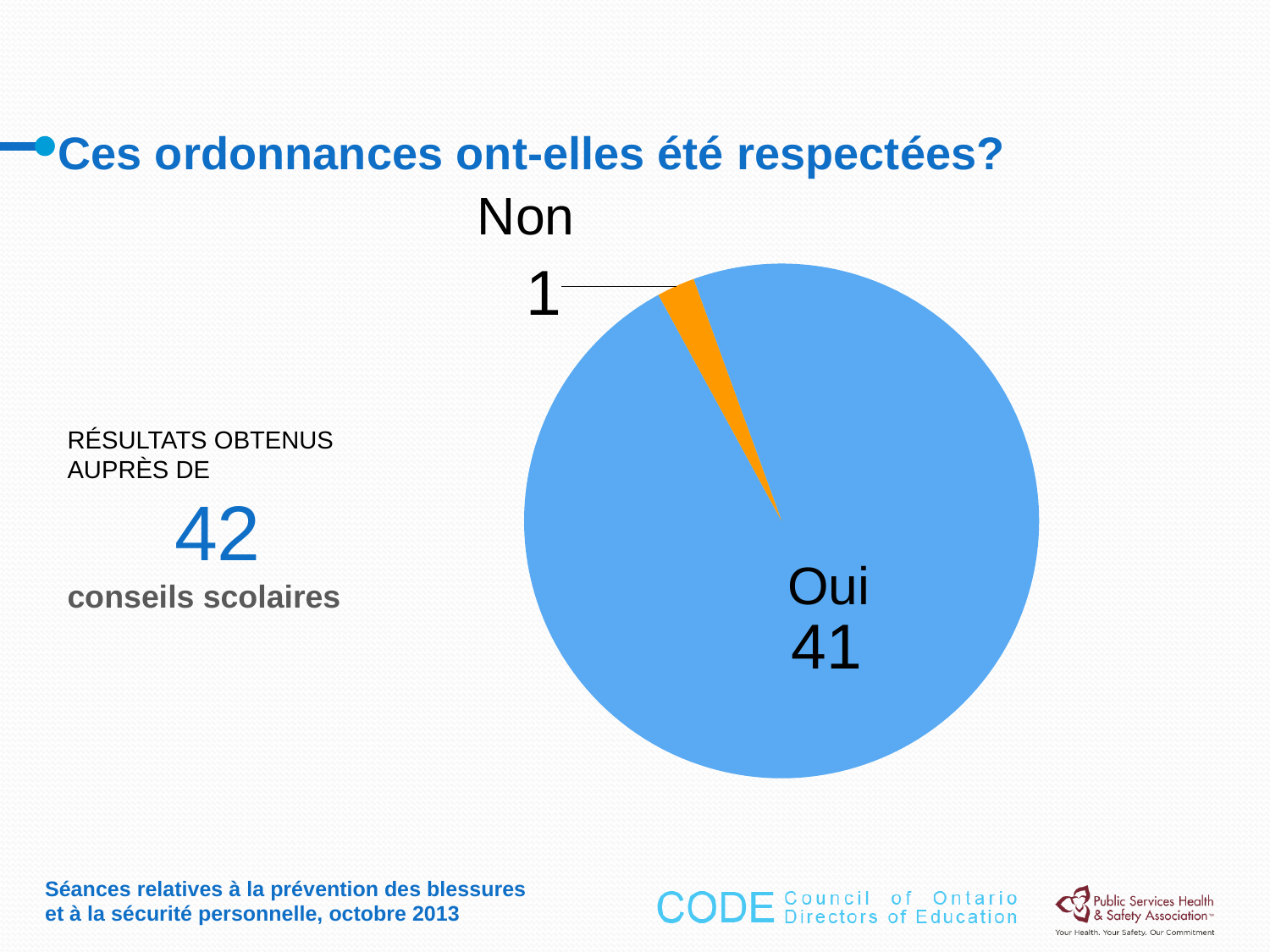
Which is larger, the value for Oui or the value for Non? Oui What is the total of all slices in the pie chart? 42 What colour is the Oui slice? blue What colour is the Non slice? orange Which category has the smallest slice? Non What is the difference between the values for Oui and Non? 40 Which category has the largest slice? Oui What is the value for Oui? 41 What is the value for Non? 1 How many slices does the pie chart have? 2 What type of chart is shown on the slide? pie chart